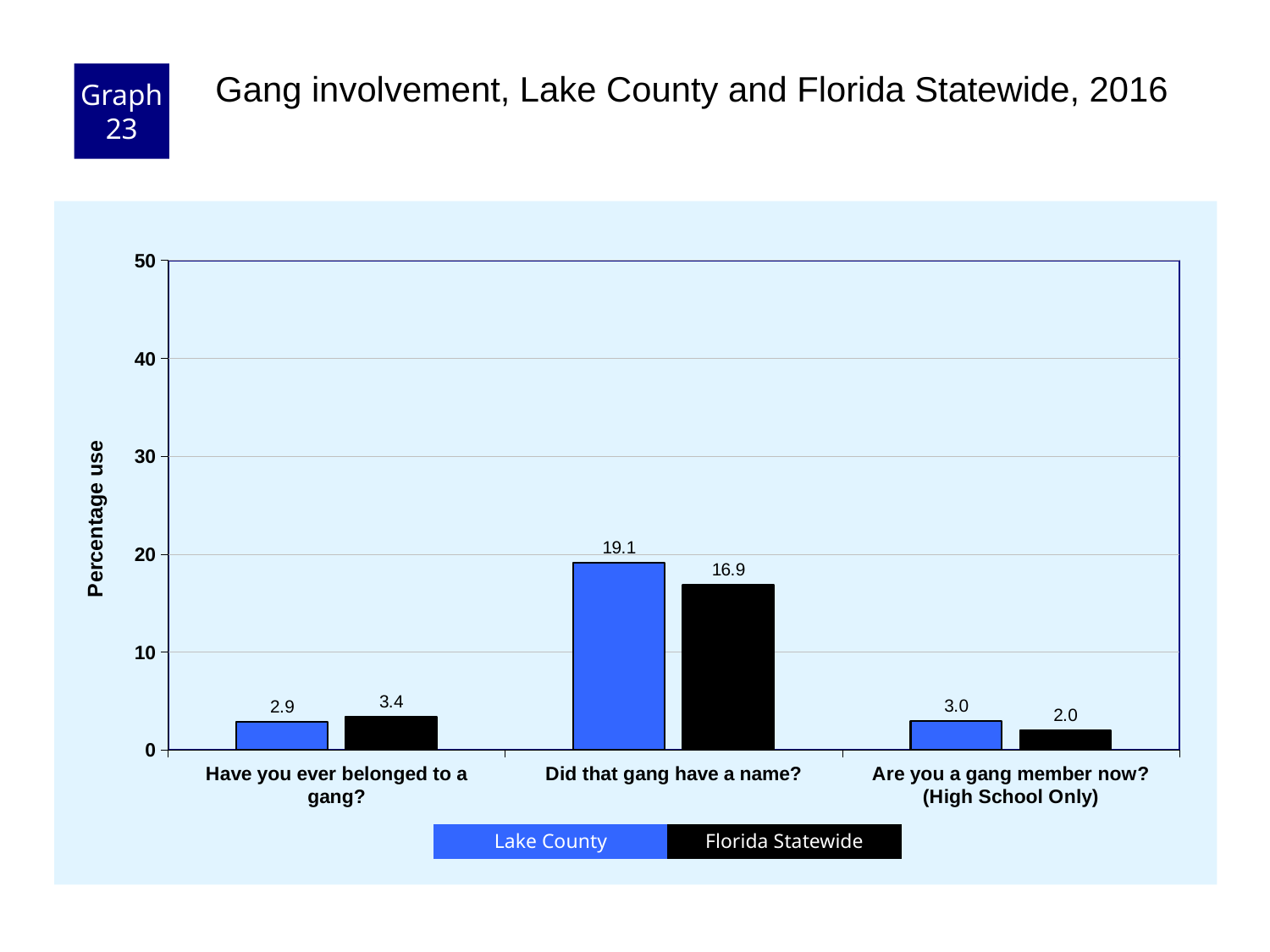
Is the Florida Statewide value for "Did that gang have a name?" greater or less than 20? less Which question has the lowest Florida Statewide value? Are you a gang member now? (High School Only) What is the Florida Statewide value for "Are you a gang member now? (High School Only)"? 2.0 How many question categories are shown on the x axis? 3 Which question has the highest Lake County value? Did that gang have a name? What is the difference between the Lake County and Florida Statewide values for "Did that gang have a name?"? 2.2 For "Have you ever belonged to a gang?", which is larger: Lake County or Florida Statewide? Florida Statewide How many series does the legend list? 2 What is the Florida Statewide value for "Have you ever belonged to a gang?"? 3.4 What is the label of the y axis? Percentage use What is the Lake County value for "Did that gang have a name?"? 19.1 What kind of chart is shown on the slide? bar chart